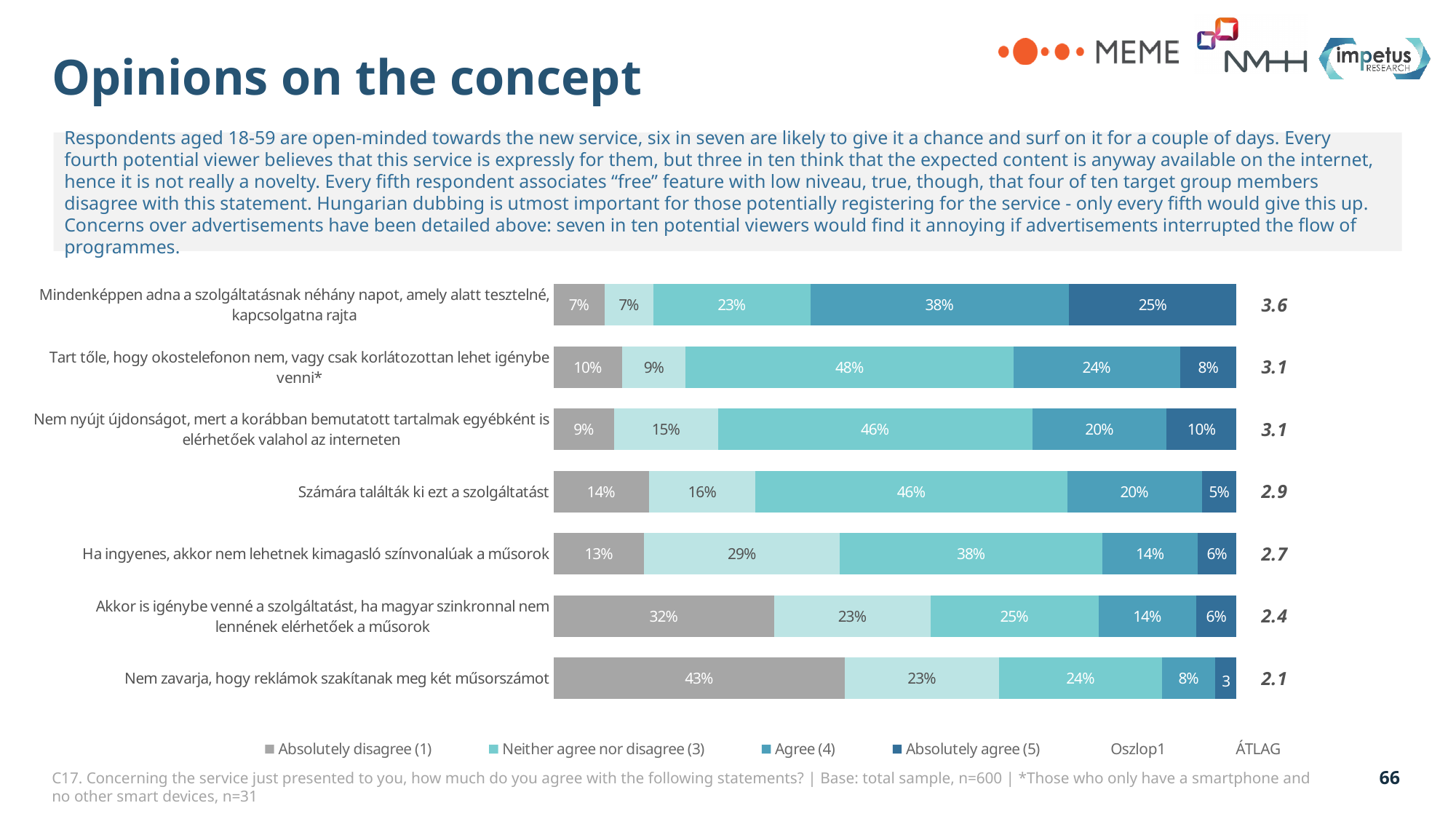
What is the 'Absolutely disagree (1)' share for 'Számára találták ki ezt a szolgáltatást'? 14% What is the 'Agree (4)' share for 'Ha ingyenes, akkor nem lehetnek kimagasló színvonalúak a műsorok'? 14% Which has the larger 'Agree (4)' share: 'Tart tőle, hogy okostelefonon nem, vagy csak korlátozottan lehet igénybe venni*' or 'Számára találták ki ezt a szolgáltatást'? Tart tőle, hogy okostelefonon nem, vagy csak korlátozottan lehet igénybe venni* What is the ÁTLAG value for 'Mindenképpen adna a szolgáltatásnak néhány napot, amely alatt tesztelné, kapcsolgatna rajta'? 3.6 Which statement has the highest ÁTLAG value? Mindenképpen adna a szolgáltatásnak néhány napot, amely alatt tesztelné, kapcsolgatna rajta What kind of chart is shown on the slide? Stacked bar chart How many statements (categories) are plotted in the chart? 7 Which statement has the lowest ÁTLAG value? Nem zavarja, hogy reklámok szakítanak meg két műsorszámot What is the 'Absolutely disagree (1)' share for 'Nem zavarja, hogy reklámok szakítanak meg két műsorszámot'? 43% What is the ÁTLAG value for 'Akkor is igénybe venné a szolgáltatást, ha magyar szinkronnal nem lennének elérhetőek a műsorok'? 2.4 What is the difference in the 'Absolutely disagree (1)' share between 'Nem zavarja, hogy reklámok szakítanak meg két műsorszámot' and 'Akkor is igénybe venné a szolgáltatást, ha magyar szinkronnal nem lennének elérhetőek a műsorok'? 11 percentage points What is the 'Absolutely agree (5)' share for 'Mindenképpen adna a szolgáltatásnak néhány napot, amely alatt tesztelné, kapcsolgatna rajta'? 25%